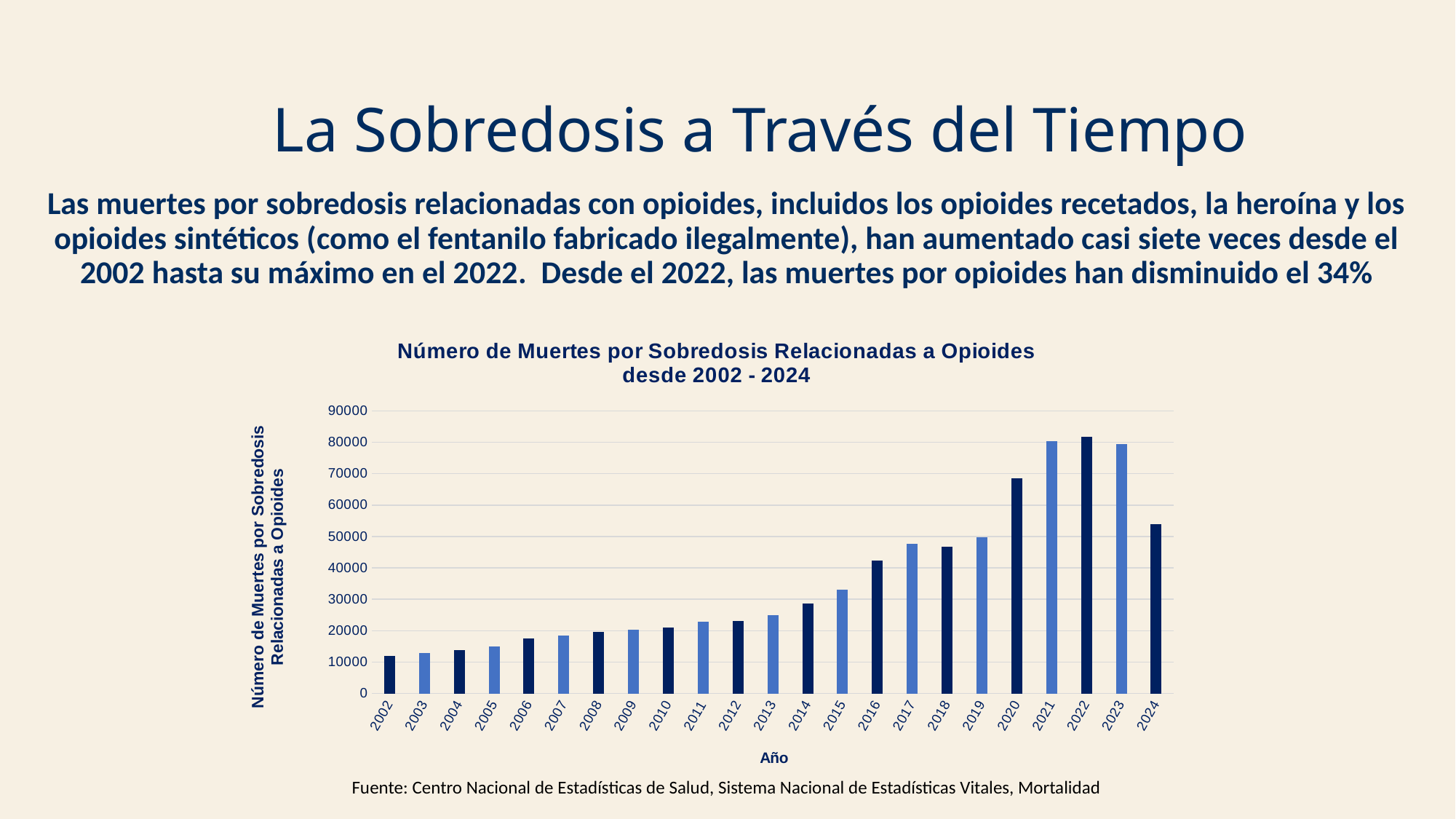
Do the values generally rise or fall from 2002 to 2022? rise What kind of chart is shown on the slide? Bar chart Is the value for 2020 greater or less than 70000? less Which year has the highest number of opioid-related overdose deaths in the chart? 2022 Which year has the lowest number of opioid-related overdose deaths in the chart? 2002 What is the label of the x axis of the chart? Año Which year has a larger value, 2020 or 2024? 2020 How many years (bars) are plotted in the chart? 23 Is the value for 2014 greater or less than 30000? less What is the title of the chart? Número de Muertes por Sobredosis Relacionadas a Opioides desde 2002 - 2024 Is the value for 2024 greater or less than 50000? greater